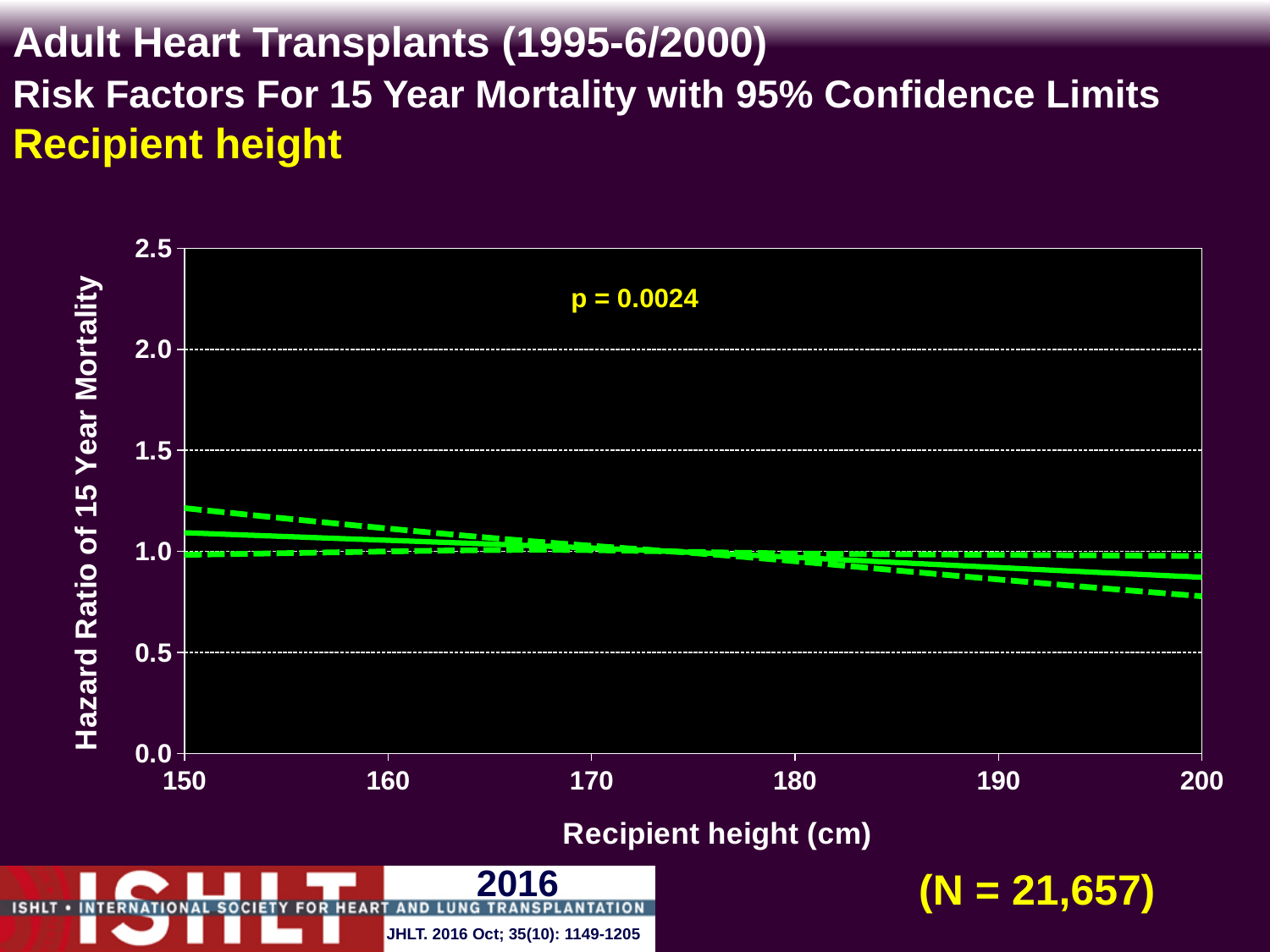
What kind of chart is shown on the slide? line chart What is the maximum value shown on the y axis? 2.5 Is the hazard ratio (solid line) at a recipient height of 150 cm greater or less than 1.0? greater How many lines are plotted on the chart (the estimate plus its confidence limits)? 3 What sample size (N) is stated on the slide? N = 21,657 What is the label of the x axis? Recipient height (cm) What p-value is printed on the chart? p = 0.0024 Is the hazard ratio (solid line) at a recipient height of 200 cm greater or less than 1.0? less Is the lower 95% confidence limit at a recipient height of 200 cm greater or less than 0.5? greater Does the hazard ratio of 15 year mortality rise or fall as recipient height increases from 150 cm to 200 cm? fall Is the hazard ratio (solid line) higher at a recipient height of 150 cm or at 200 cm? 150 cm